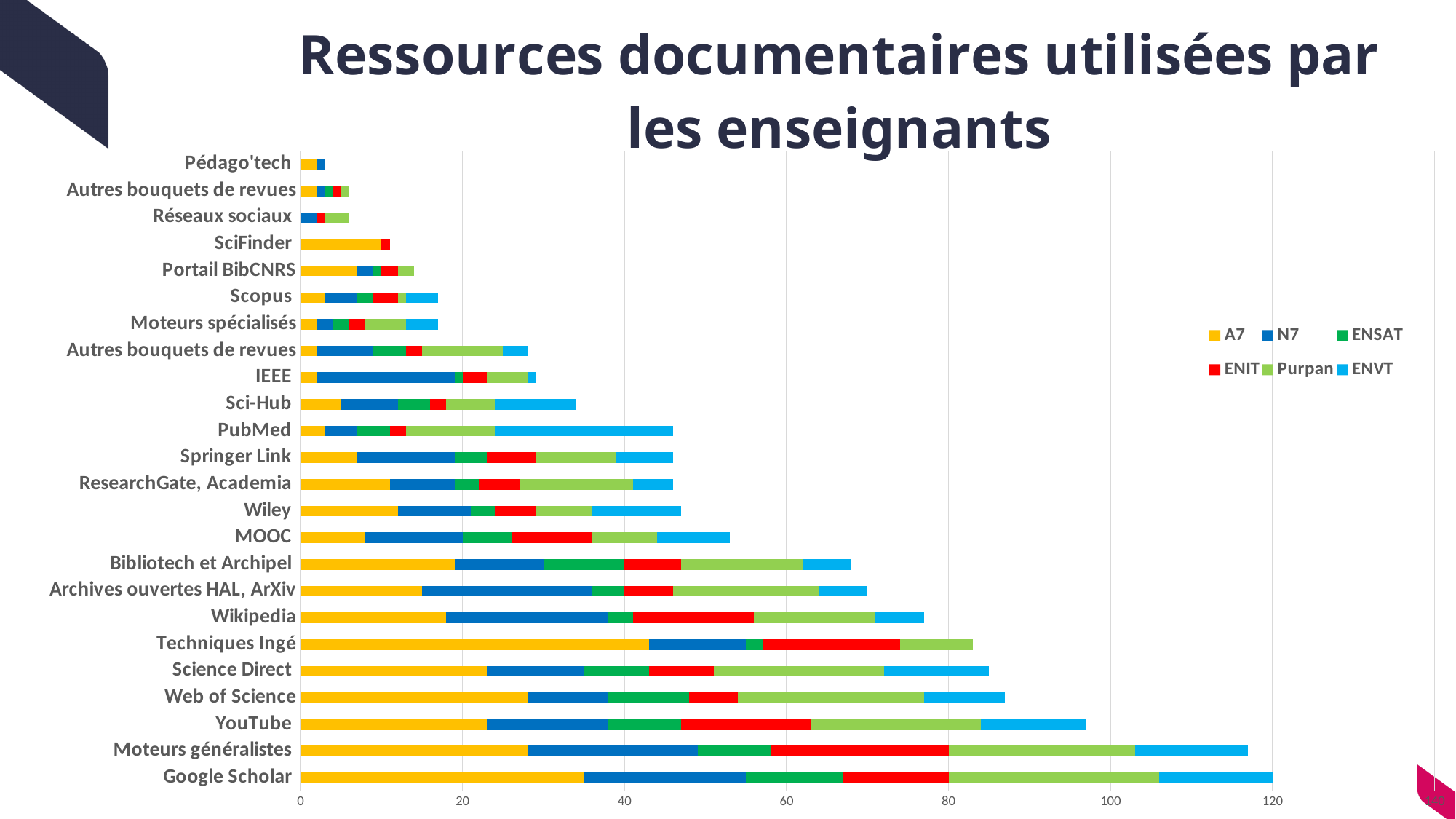
What is the title of the chart? Ressources documentaires utilisées par les enseignants Is the total value for MOOC greater or less than 40? greater Is the total value for Moteurs généralistes greater or less than 100? greater Which resource has the longest total bar? Google Scholar Which has the larger total bar, PubMed or Sci-Hub? PubMed What kind of chart is shown on the slide? Stacked bar chart How many categories (resources) are plotted on the chart? 24 Is the total value for Wikipedia greater or less than 80? less How many series does the legend list? 6 Which has the larger total bar, YouTube or Web of Science? YouTube Which resource has the shortest total bar? Pédago'tech